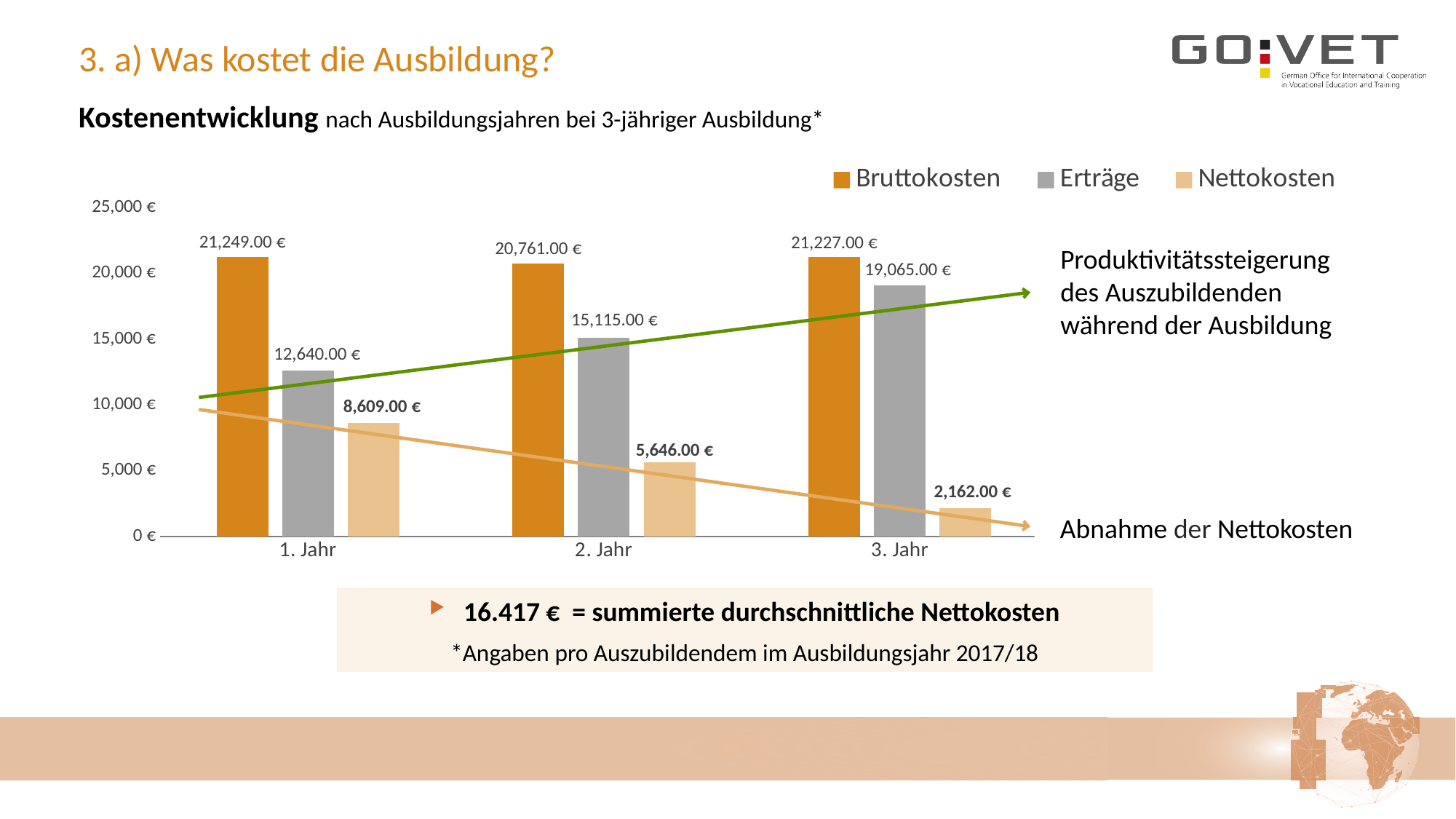
What is the Erträge value for 2. Jahr? 15,115.00 € How many series does the legend list? 3 What is the difference between Bruttokosten and Erträge in 2. Jahr? 5,646.00 € What is the Bruttokosten value for 1. Jahr? 21,249.00 € How many years (categories) are shown on the x axis? 3 Which year has the highest Erträge value? 3. Jahr Which year has the lowest Nettokosten value? 3. Jahr What is the Nettokosten value for 3. Jahr? 2,162.00 € Is the Erträge value for 1. Jahr greater or less than 15,000 €? less What kind of chart is shown on the slide? bar chart Which is larger, the Bruttokosten for 1. Jahr or the Bruttokosten for 2. Jahr? Bruttokosten for 1. Jahr Do the Nettokosten values rise or fall from 1. Jahr to 3. Jahr? fall